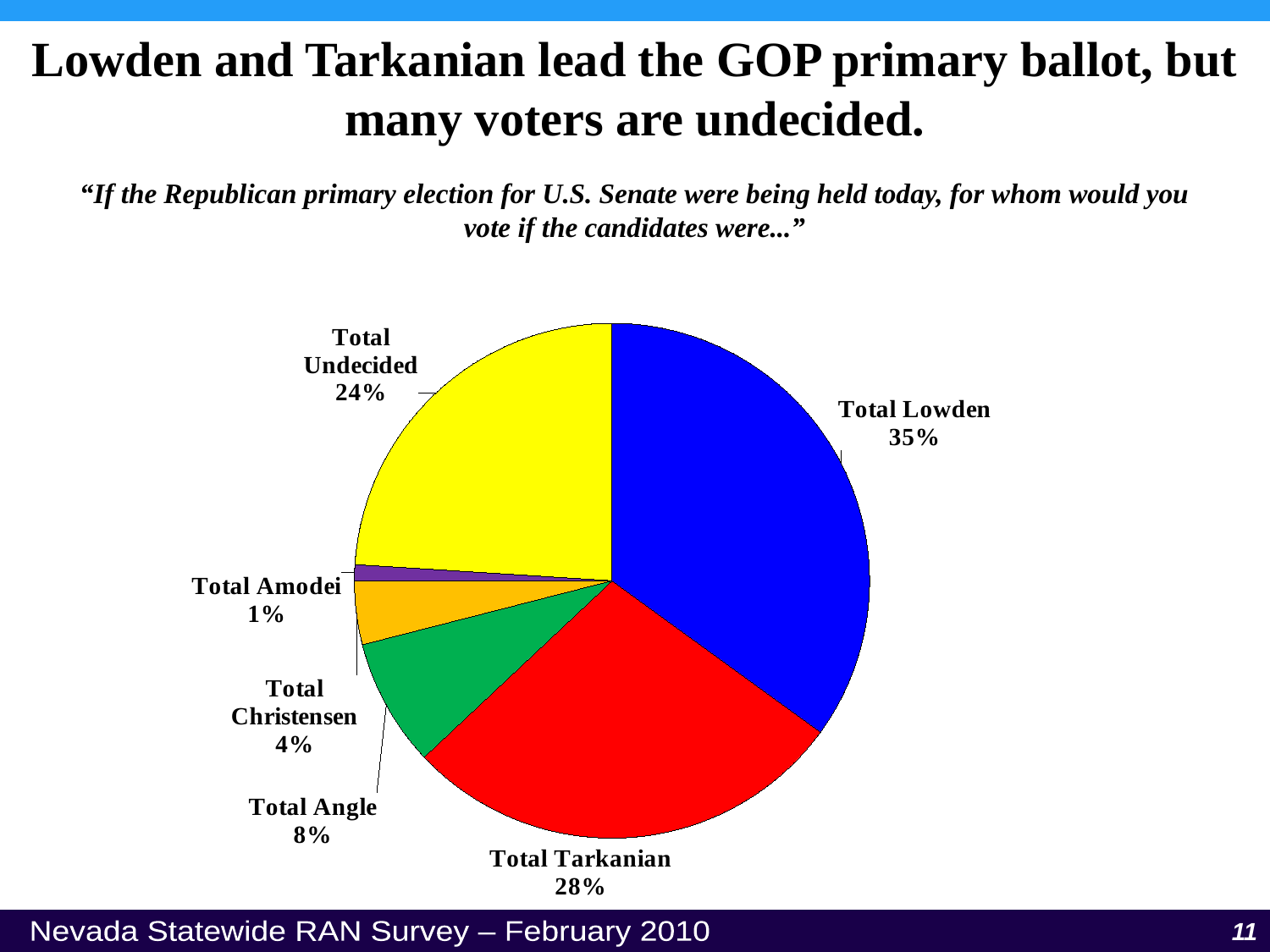
Which slice of the pie is the largest? Total Lowden What share of the pie does Total Lowden hold? 35% Which is larger, Total Undecided or Total Tarkanian? Total Tarkanian What percentage is labelled for Total Undecided? 24% What is the value shown for Total Tarkanian? 28% Which slice of the pie is the smallest? Total Amodei What is the difference between Total Angle and Total Christensen? 4% What is the value for Total Angle? 8% How many slices does the pie chart have? 6 What colour is the Total Undecided slice? Yellow What is the difference between Total Lowden and Total Tarkanian? 7% What kind of chart is shown on the slide? Pie chart